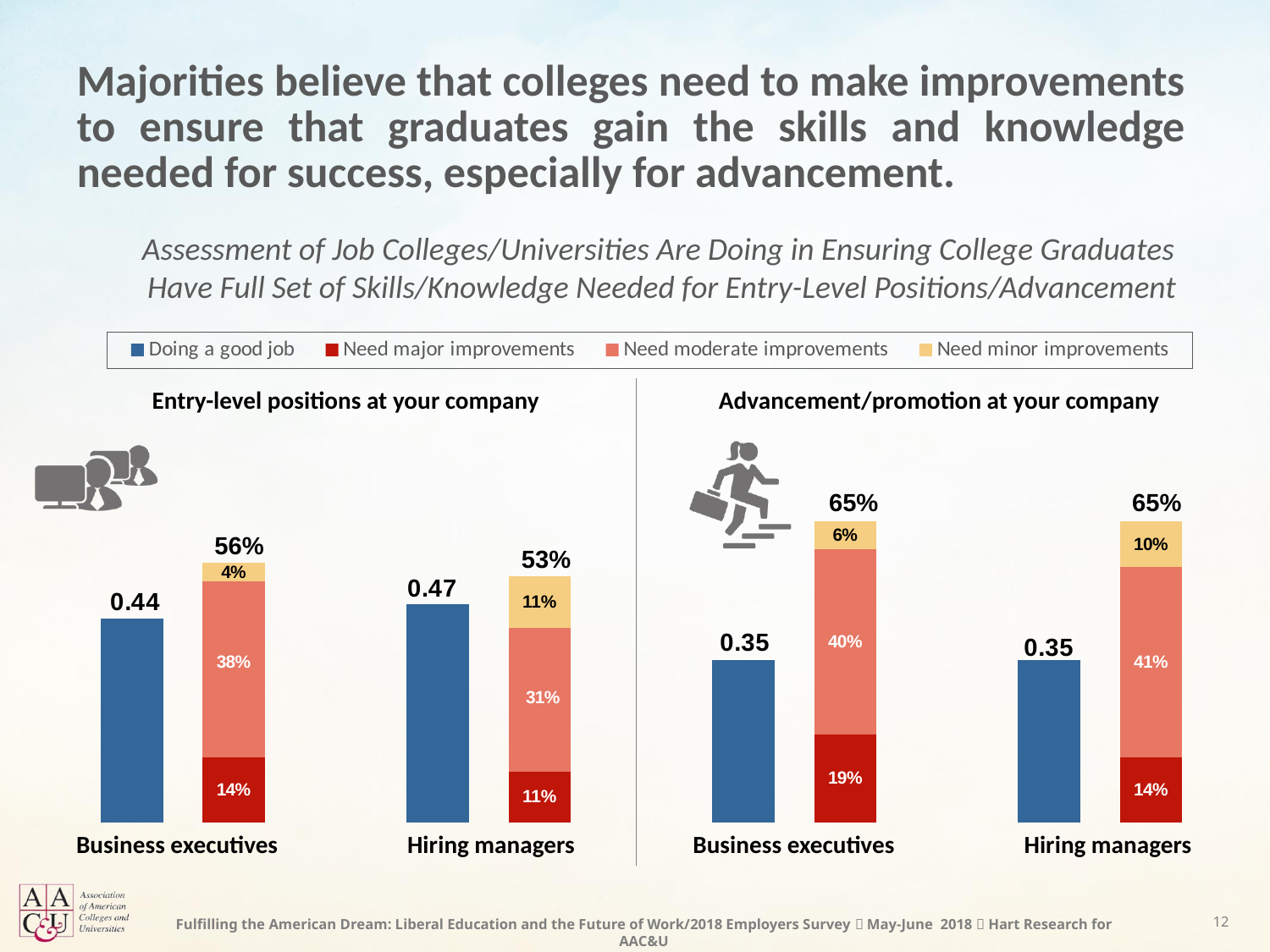
Which legend entry is shown in blue? Doing a good job In the 'Entry-level positions at your company' chart, which group has the higher 'Doing a good job' value? Hiring managers In the 'Entry-level positions at your company' chart, what is the 'Doing a good job' value for Business executives? 0.44 How many series does the legend list? 4 In the 'Advancement/promotion at your company' chart, what is the total of the stacked improvements bar for Hiring managers? 65% In the 'Advancement/promotion at your company' chart, what percentage of Business executives say colleges need major improvements? 19% In the 'Entry-level positions at your company' chart, what percentage of Hiring managers say colleges need moderate improvements? 31% In the 'Advancement/promotion at your company' chart, what percentage of Hiring managers say colleges need minor improvements? 10% What kind of chart is used on this slide? Bar chart In the 'Entry-level positions at your company' chart, what is the difference between the 'Need moderate improvements' values for Business executives and Hiring managers? 7 percentage points In the 'Advancement/promotion at your company' chart, which group has the higher 'Need major improvements' value, Business executives or Hiring managers? Business executives In the 'Entry-level positions at your company' chart, what is the total of the stacked improvements bar for Business executives? 56%